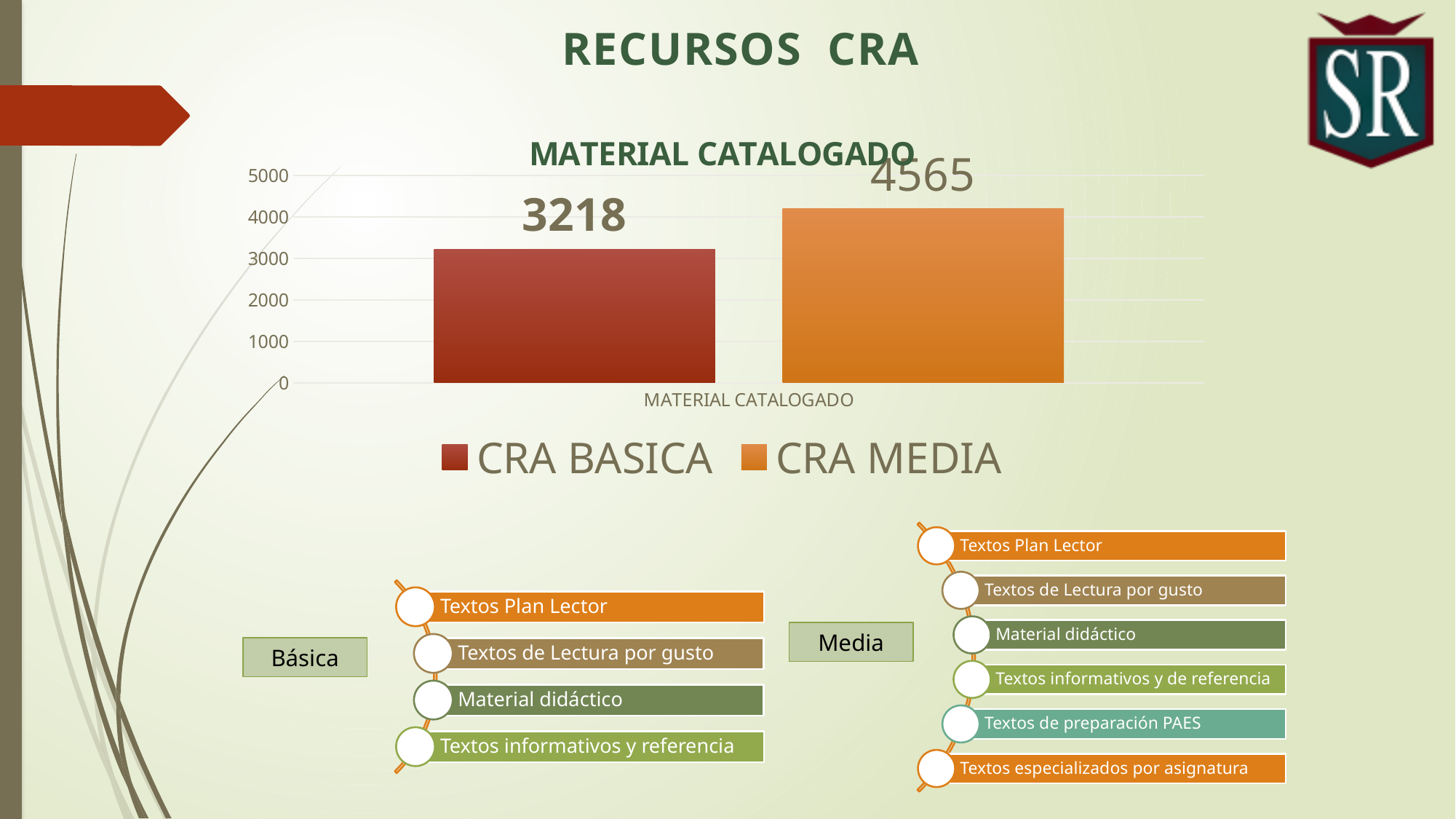
Which series has the lower value in the MATERIAL CATALOGADO chart? CRA BASICA Is the value for CRA MEDIA greater or less than 4000? greater How many series does the legend list? 2 What is the highest value shown on the vertical axis of the chart? 5000 What is the difference between the CRA MEDIA and CRA BASICA values? 1347 What is the value for CRA BASICA in the MATERIAL CATALOGADO chart? 3218 Is the value for CRA BASICA greater or less than 4000? less Is the value for CRA BASICA larger or smaller than the value for CRA MEDIA? smaller What is the value for CRA MEDIA in the MATERIAL CATALOGADO chart? 4565 What is the title of the chart? MATERIAL CATALOGADO What kind of chart is shown on the slide? bar chart Which series has the higher value in the MATERIAL CATALOGADO chart? CRA MEDIA